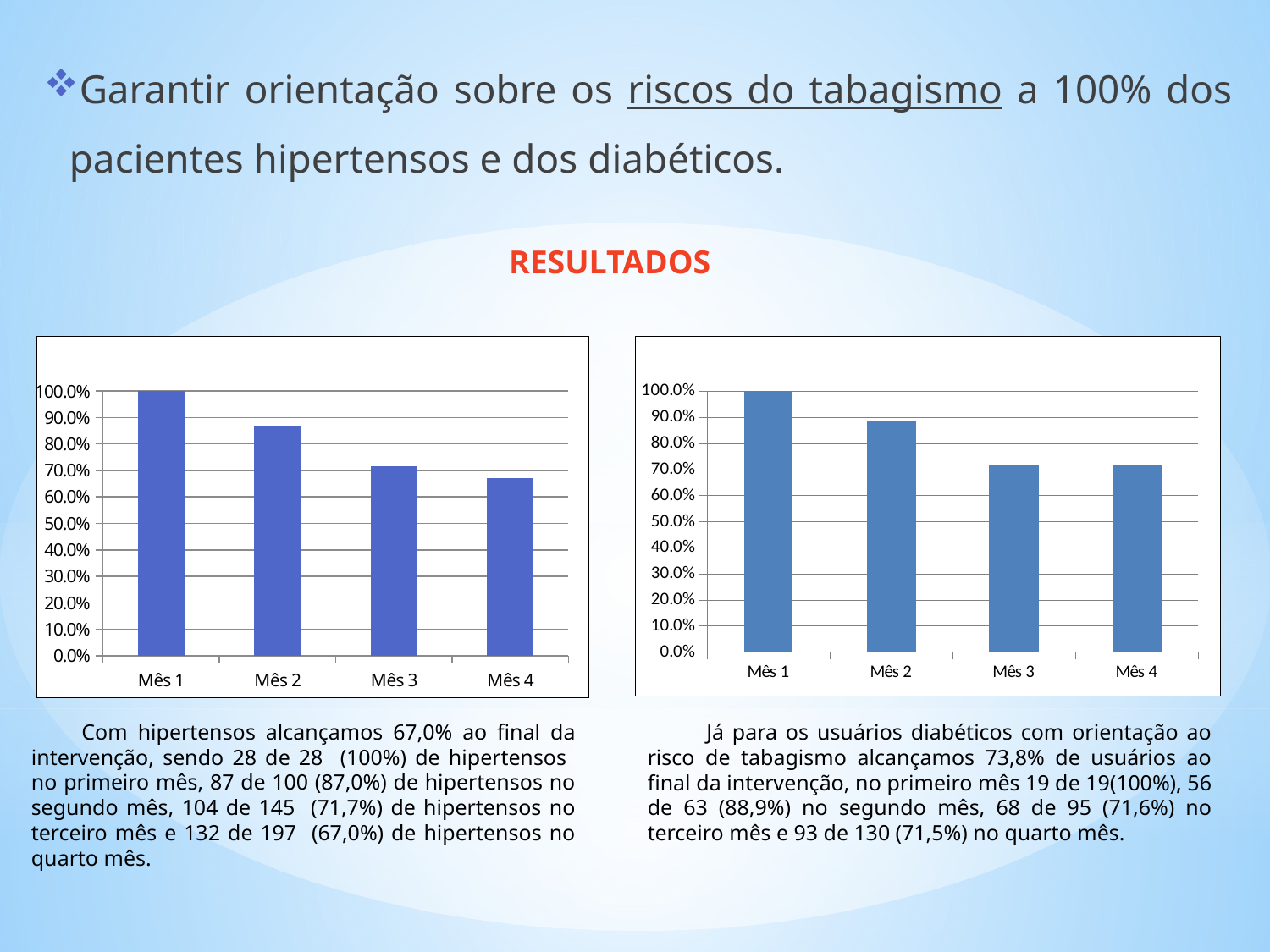
On the left chart, is the value for Mês 2 greater or less than 80.0%? greater How many months are shown on the left chart? 4 What kind of chart is the right chart? bar chart On the left chart, is the value for Mês 4 greater or less than 70.0%? less On the left chart, what is the value for Mês 1? 100.0% On the right chart, is the value for Mês 3 greater or less than 80.0%? less On the left chart, which month has the lowest value? Mês 4 On the right chart, what is the value for Mês 1? 100.0% On the right chart, which month has the highest value? Mês 1 On the left chart, which is larger, the value for Mês 2 or the value for Mês 3? Mês 2 On the left chart, which month has the highest value? Mês 1